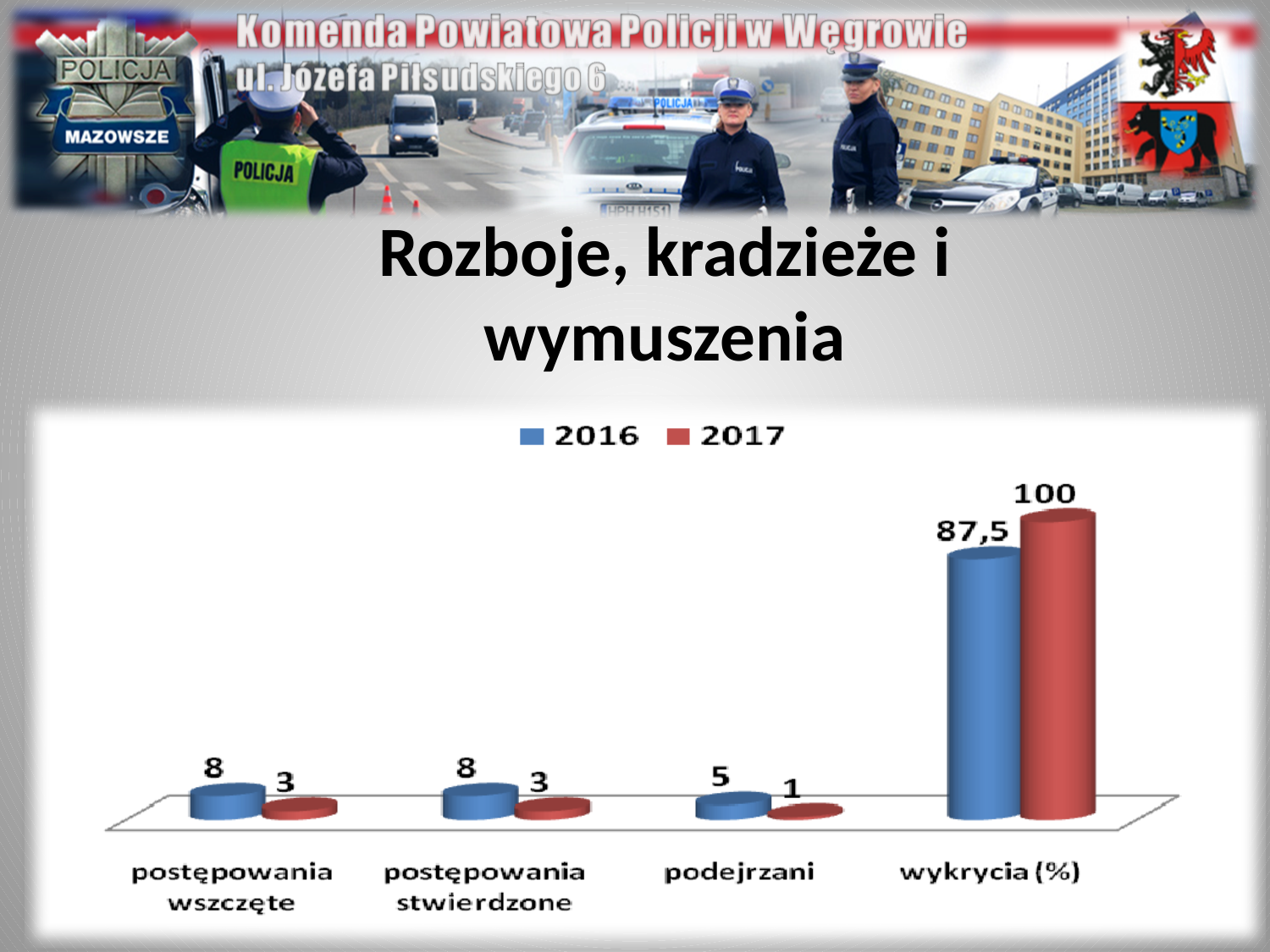
What is the difference between the 2017 and 2016 values in the 'wykrycia (%)' category? 12,5 Which category has the lowest value for the 2017 series? podejrzani How many series does the legend list? 2 Which category has the highest value for the 2017 series? wykrycia (%) In the 'podejrzani' category, which series has the larger value, 2016 or 2017? 2016 How many categories are shown on the x axis of the chart? 4 What is the value for 2017 in the 'podejrzani' category? 1 What kind of chart is shown on the slide? bar chart What is the value for 2016 in the 'postępowania wszczęte' category? 8 What is the value for 2017 in the 'wykrycia (%)' category? 100 What is the difference between the 2016 and 2017 values in the 'postępowania stwierdzone' category? 5 What is the value for 2016 in the 'wykrycia (%)' category? 87,5